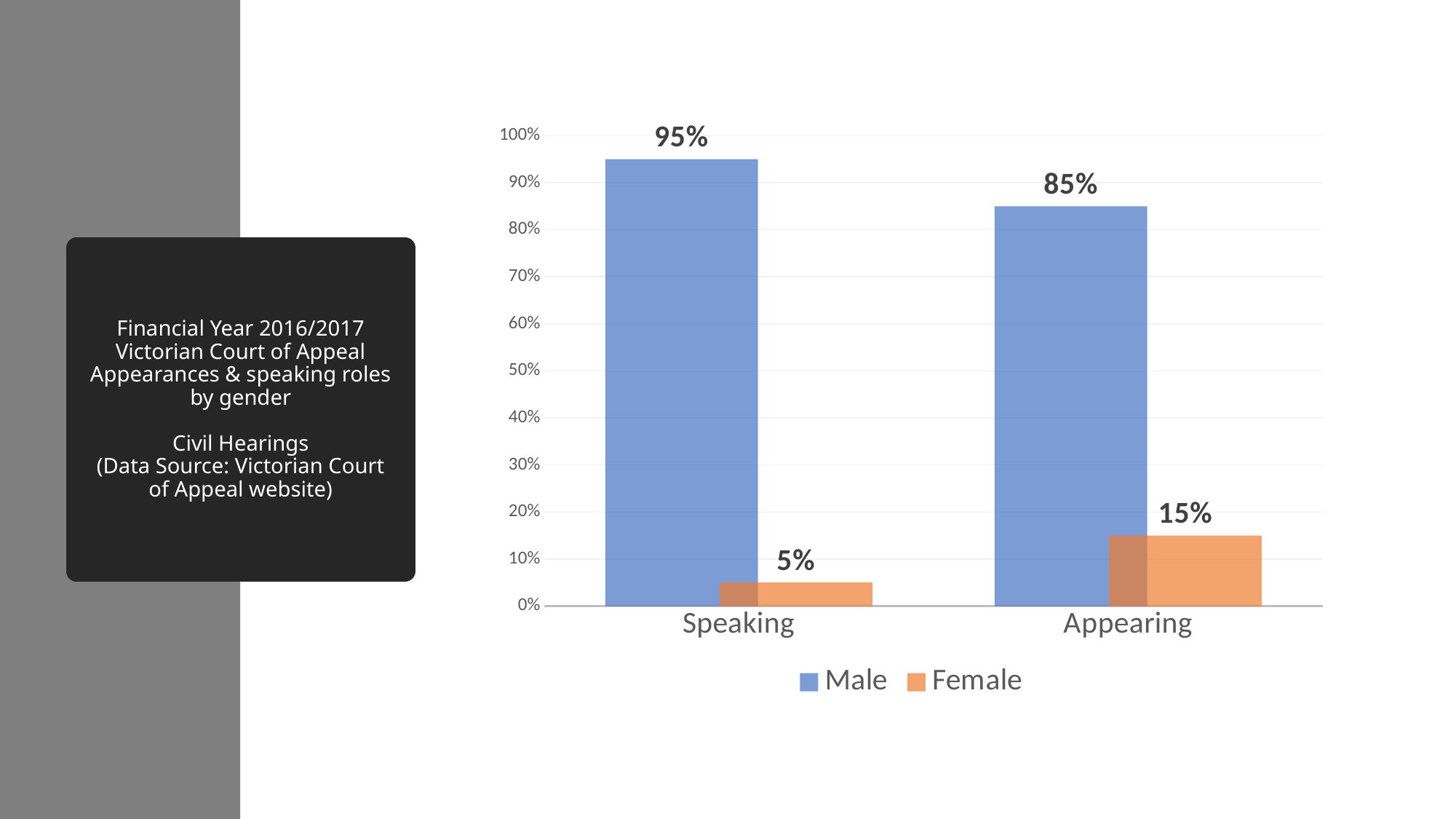
Which category has the lowest Female value? Speaking What is the Male value for Appearing? 85% What is the Female value for Appearing? 15% What kind of chart is shown on the slide? Bar chart Which colour represents the Female series? Orange What is the Female value for Speaking? 5% Which is larger, the Female value for Speaking or the Female value for Appearing? Appearing What is the Male value for Speaking? 95% How many categories are shown on the x axis? 2 What is the difference between the Male and Female values for Appearing? 70% How many series does the legend list? 2 Which category has the highest Male value? Speaking